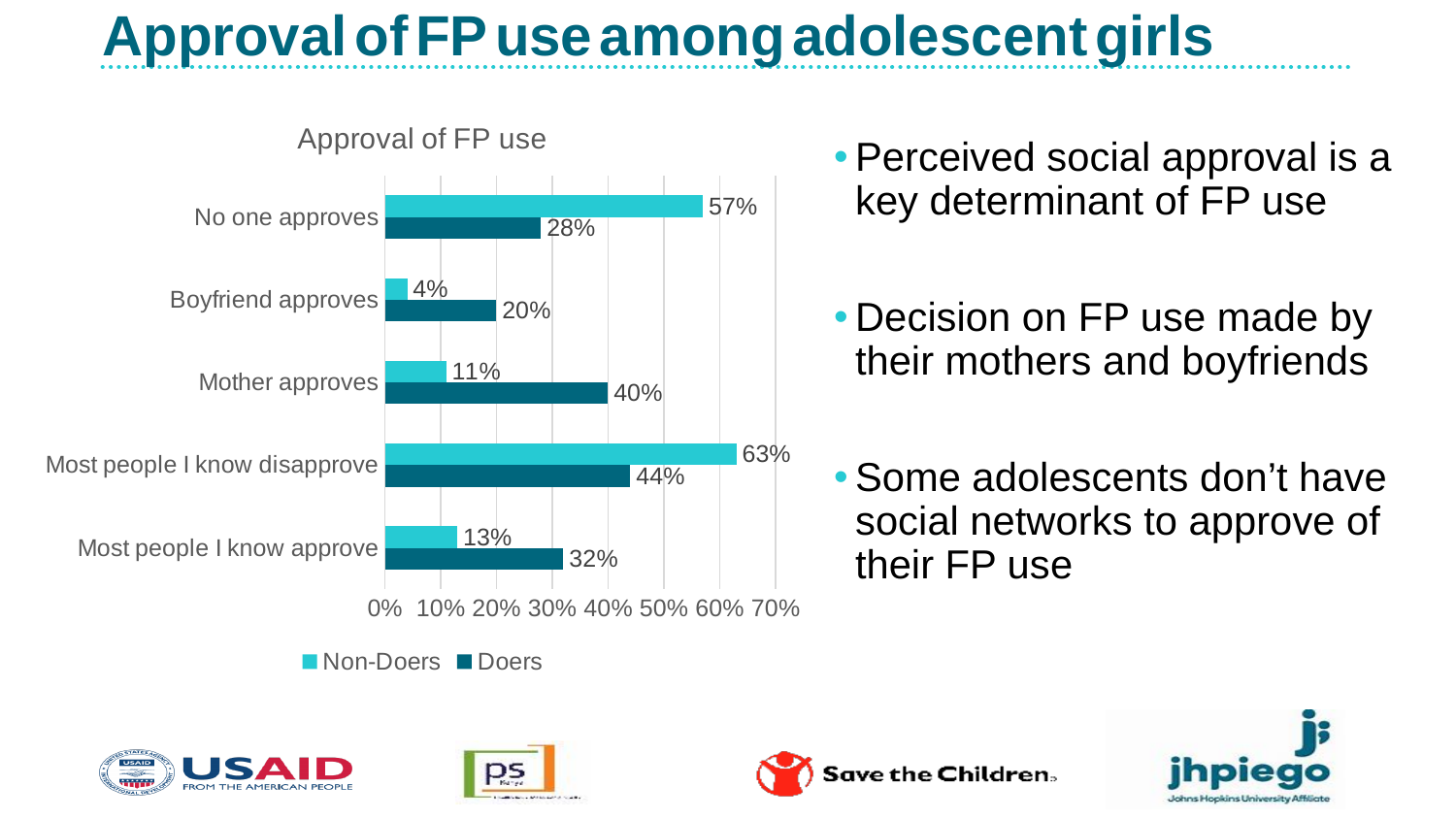
Which category has the highest Doers value? Most people I know disapprove How many series does the legend list? 2 What is the difference between the Non-Doers and Doers values for "No one approves"? 29% Which category has the highest Non-Doers value? Most people I know disapprove For "Most people I know approve", which series has the larger value, Non-Doers or Doers? Doers What kind of chart is shown on the slide? Bar chart What is the title of the chart? Approval of FP use What is the Non-Doers value for "No one approves"? 57% What is the Doers value for "Mother approves"? 40% Which category has the lowest Non-Doers value? Boyfriend approves How many categories are shown on the chart? 5 What is the Doers value for "Boyfriend approves"? 20%